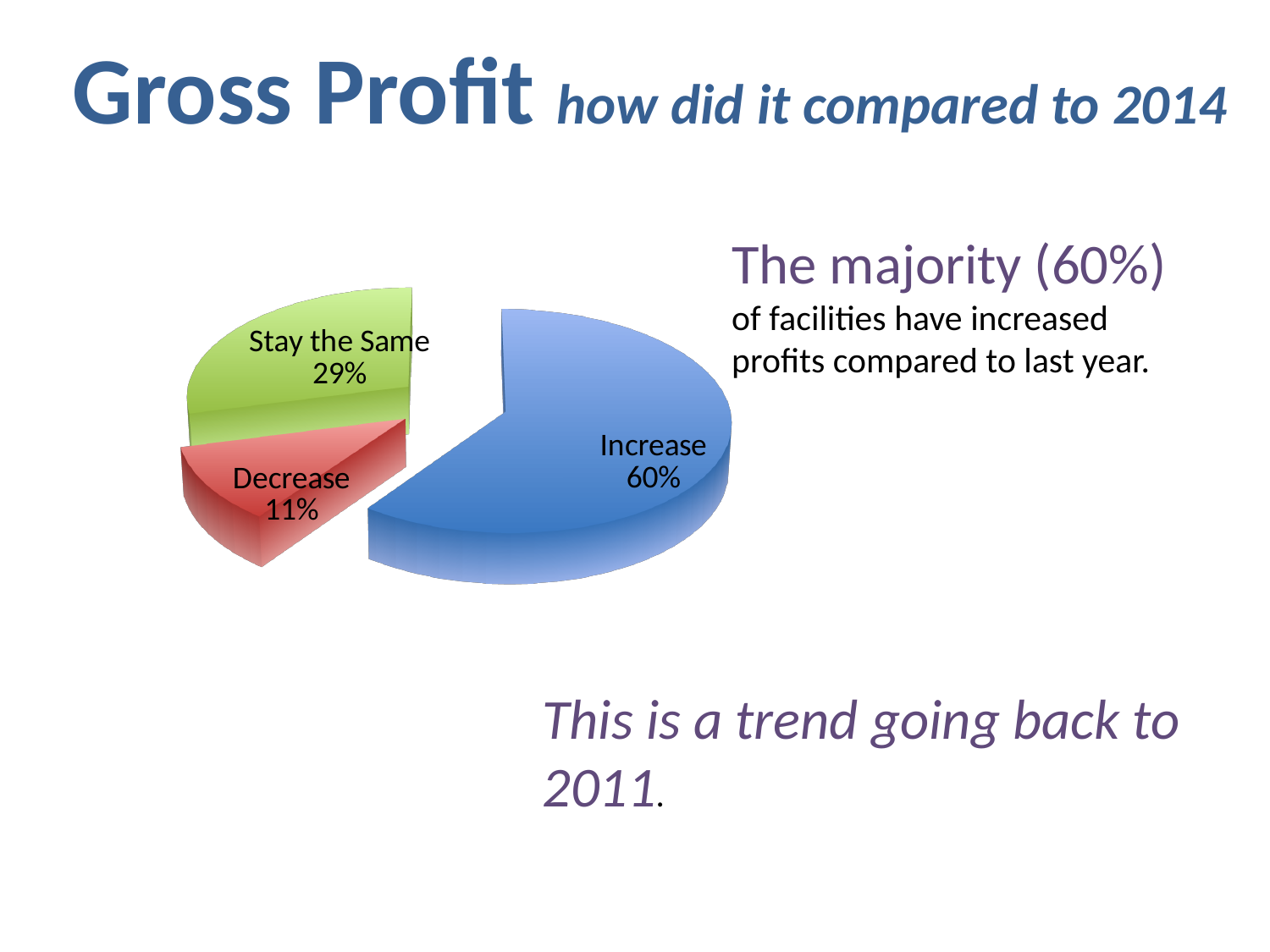
Which category has the smallest share of the pie? Decrease Which category has the largest share of the pie? Increase How many slices does the pie chart have? 3 What percentage of facilities reported a decrease in gross profit? 11% What percentage of facilities reported an increase in gross profit? 60% What kind of chart is shown on the slide? pie chart Which is larger, the Stay the Same slice or the Decrease slice? Stay the Same What is the difference in percentage points between the Increase and Stay the Same slices? 31 What percentage of facilities reported that gross profit stayed the same? 29% What colour is the Decrease slice of the pie chart? red What colour is the Increase slice of the pie chart? blue What is the difference in percentage points between the Stay the Same and Decrease slices? 18